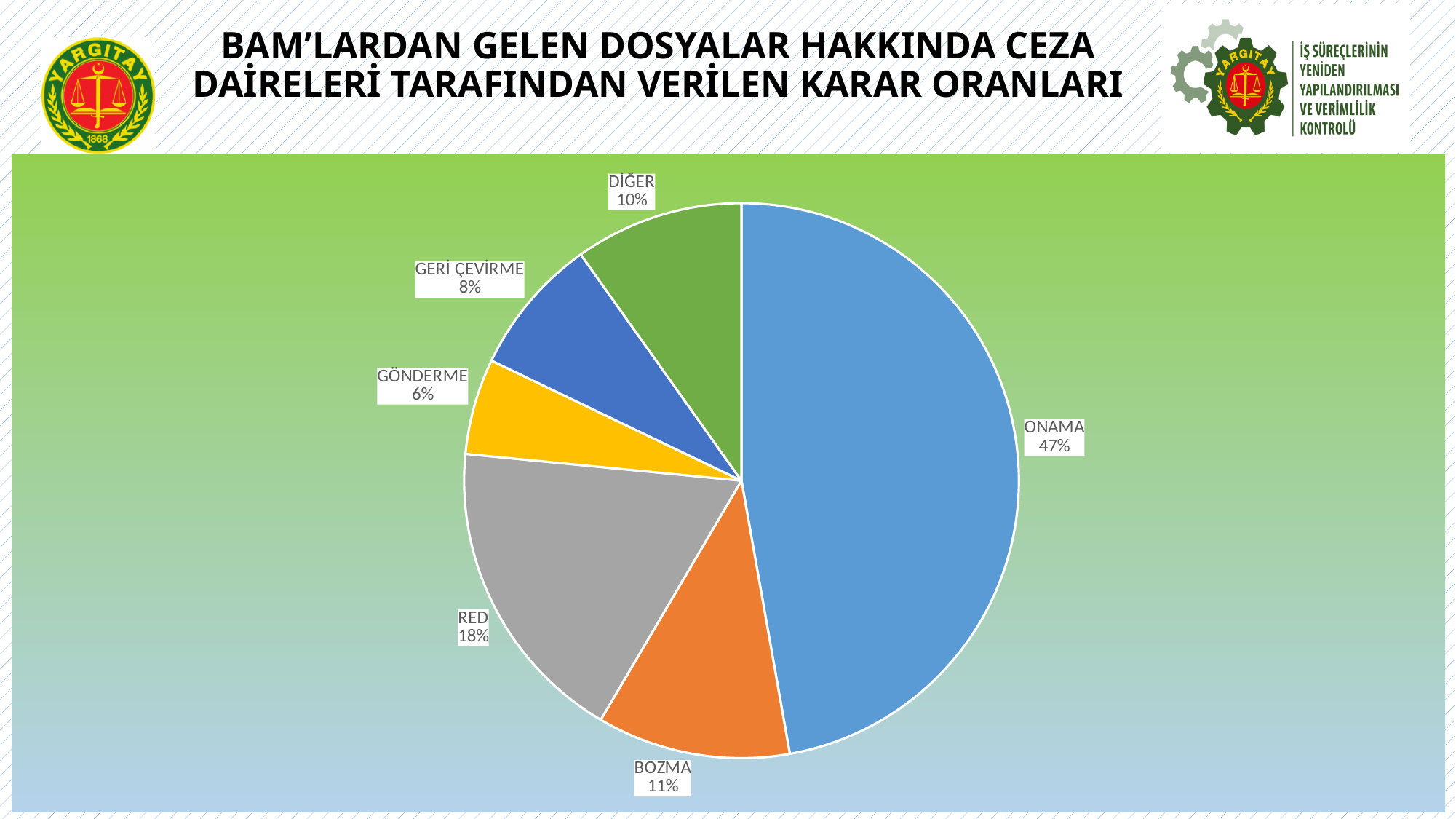
What type of chart is shown on the slide? pie chart What is the value shown for DİĞER? 10% Which category has the smallest share of the pie? GÖNDERME What share of the pie does ONAMA represent? 47% What is the value shown for GERİ ÇEVİRME? 8% What is the difference in percentage points between ONAMA and RED? 29 How many slices does the pie chart have? 6 What is the value shown for RED? 18% What is the value shown for BOZMA? 11% What colour is the ONAMA slice? blue Which category has the largest share of the pie? ONAMA Which is larger, the share for BOZMA or the share for DİĞER? BOZMA